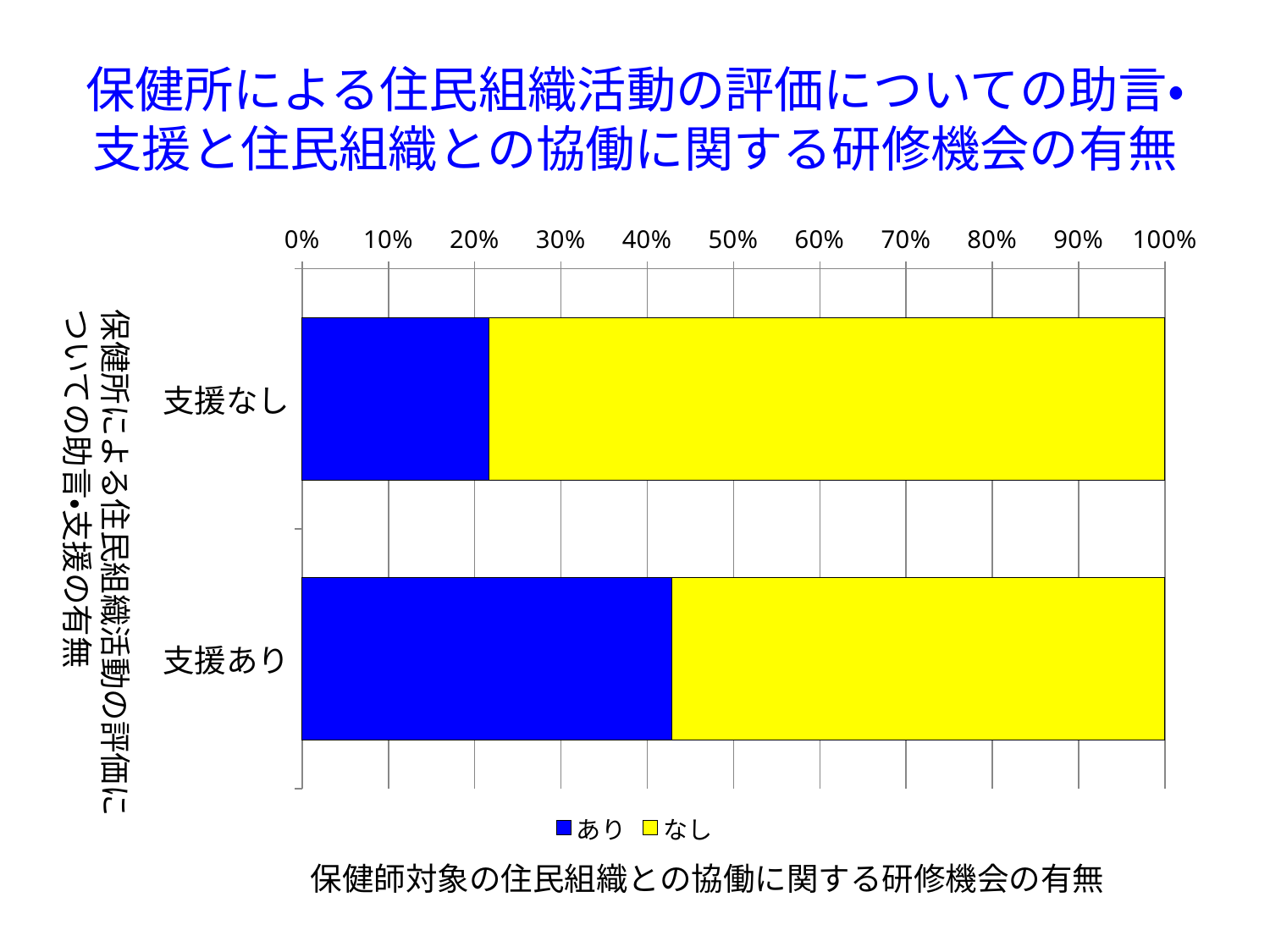
Which colour represents the series あり in the chart? blue Is the value for あり in the 支援あり bar greater or less than 40%? greater How many series does the chart's legend list? 2 What kind of chart is shown on the slide? bar chart Which category has the larger share of あり, 支援あり or 支援なし? 支援あり Is the value for あり in the 支援なし bar greater or less than 30%? less Is the share of なし in the 支援なし bar greater or less than 70%? greater Which category has the larger share of なし, 支援あり or 支援なし? 支援なし How many categories are plotted on the vertical axis of the chart? 2 What are the two entries in the chart's legend? あり, なし In the 支援あり bar, which is larger, the あり segment or the なし segment? なし